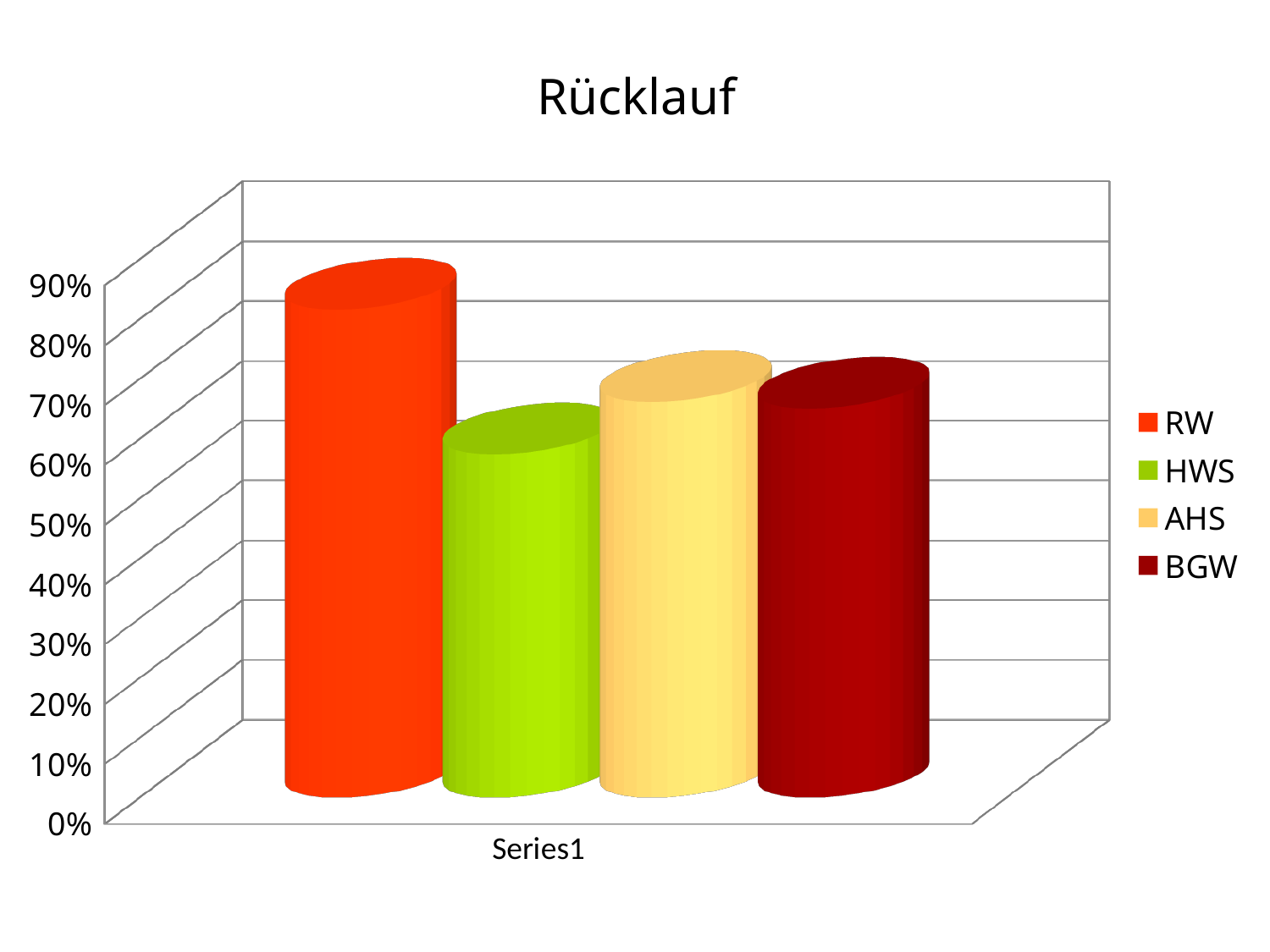
Is the value for HWS greater or less than 80%? less Which series has the highest value? RW Which is larger, the value for RW or the value for HWS? RW What is the title of the chart? Rücklauf How many bars are plotted in the chart? 4 Is the value for BGW greater or less than 50%? greater Is the value for RW greater or less than 70%? greater Which series has the lowest value? HWS What label is shown on the category axis below the bars? Series1 How many series does the legend list? 4 Which is larger, the value for AHS or the value for HWS? AHS What kind of chart is shown on the slide? bar chart